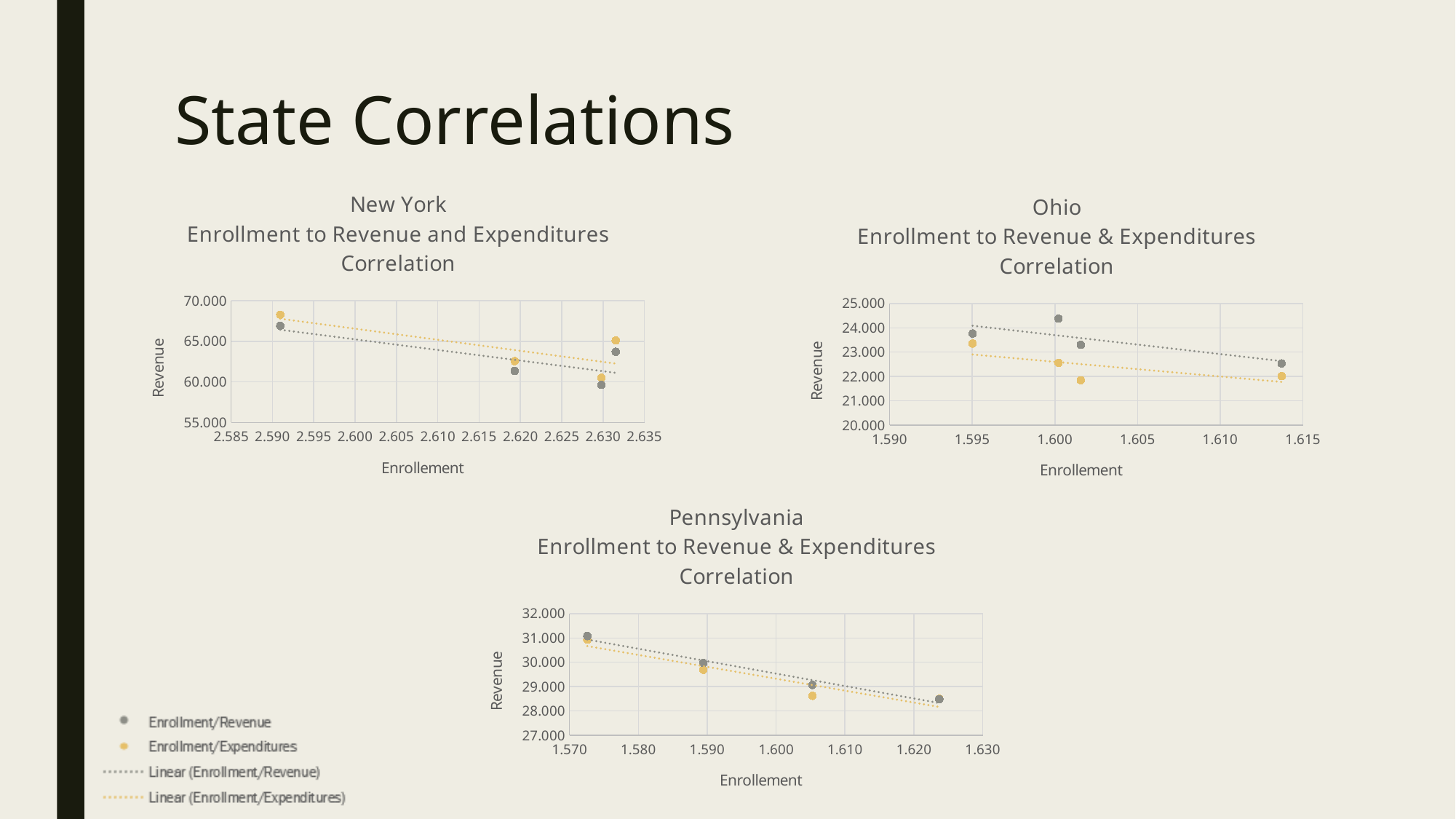
In the New York chart, does the Linear (Enrollment/Expenditures) trend line slope upward or downward from left to right? Downward What type of chart is the New York Enrollment to Revenue and Expenditures Correlation chart? Scatter chart In the Pennsylvania chart, do the Enrollment/Revenue values rise or fall as enrollment increases along the x axis? Fall What is the label on the x axis of the Ohio chart? Enrollement In the Pennsylvania chart, how many Enrollment/Revenue points are plotted? 4 In the Pennsylvania chart, is the rightmost Enrollment/Revenue point (near enrollment 1.624) greater or less than 29.000? less How many entries does the legend at the bottom left of the slide list? 4 In the Ohio chart, how many Enrollment/Expenditures points are plotted? 4 In the New York chart, is the leftmost Enrollment/Expenditures point (near enrollment 2.591) greater or less than 65.000? greater Which colour represents the Enrollment/Expenditures series in the legend? Yellow How many charts are shown on the slide? 3 In the Ohio chart, is the highest Enrollment/Revenue point (near enrollment 1.600) greater or less than 24.000? greater